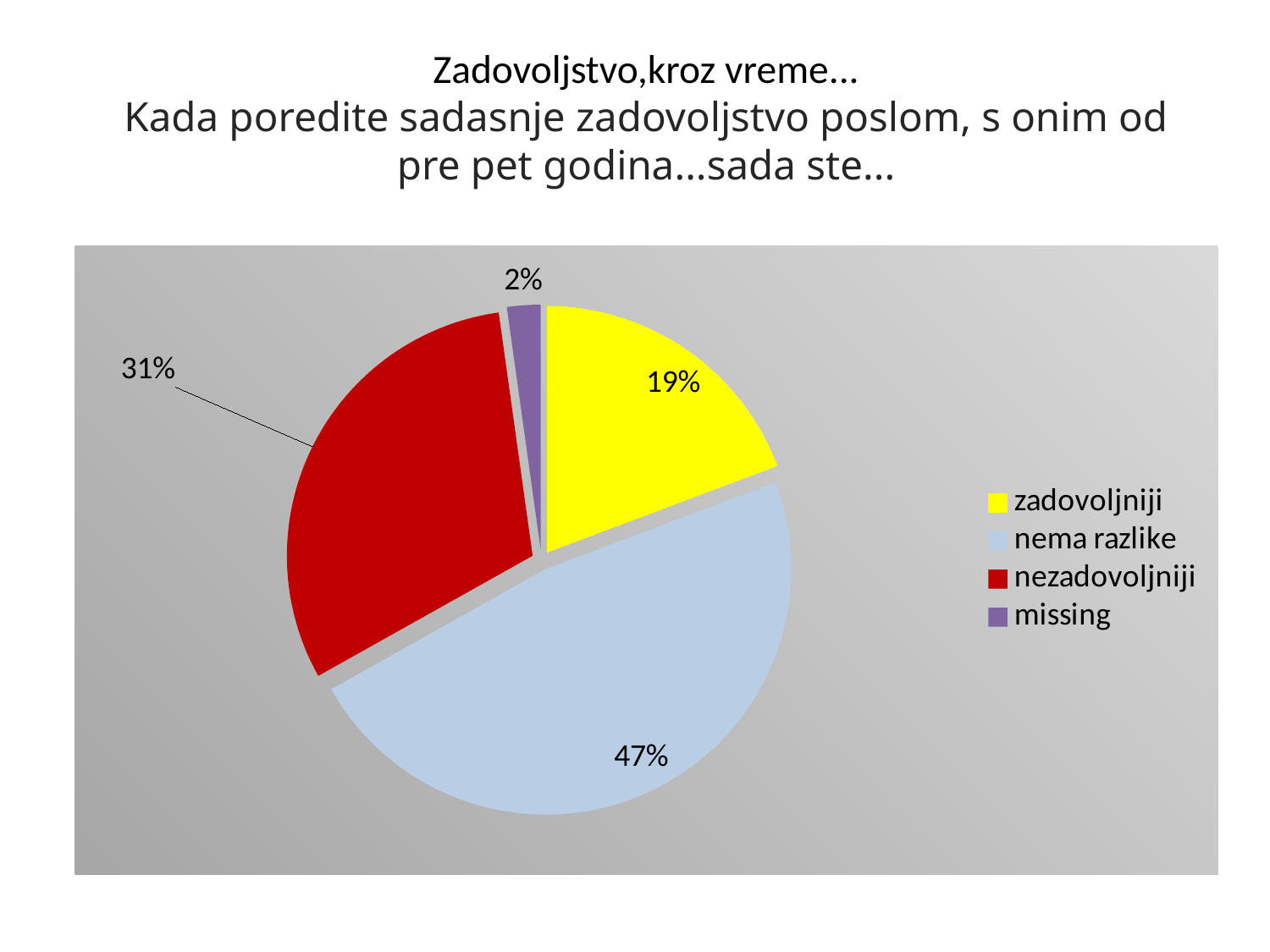
How many categories does the legend list? 4 Which slice is larger, "zadovoljniji" or "nezadovoljniji"? nezadovoljniji What percentage of the pie is labelled "missing"? 2% What is the difference in percentage points between "nema razlike" and "nezadovoljniji"? 16 What colour is the "nezadovoljniji" slice? red What percentage of the pie is labelled "nema razlike"? 47% What colour is the "zadovoljniji" slice? yellow What percentage of the pie is labelled "nezadovoljniji"? 31% Which category has the largest slice of the pie? nema razlike What type of chart is shown on the slide? pie chart Which category has the smallest slice of the pie? missing What percentage of the pie is labelled "zadovoljniji"? 19%